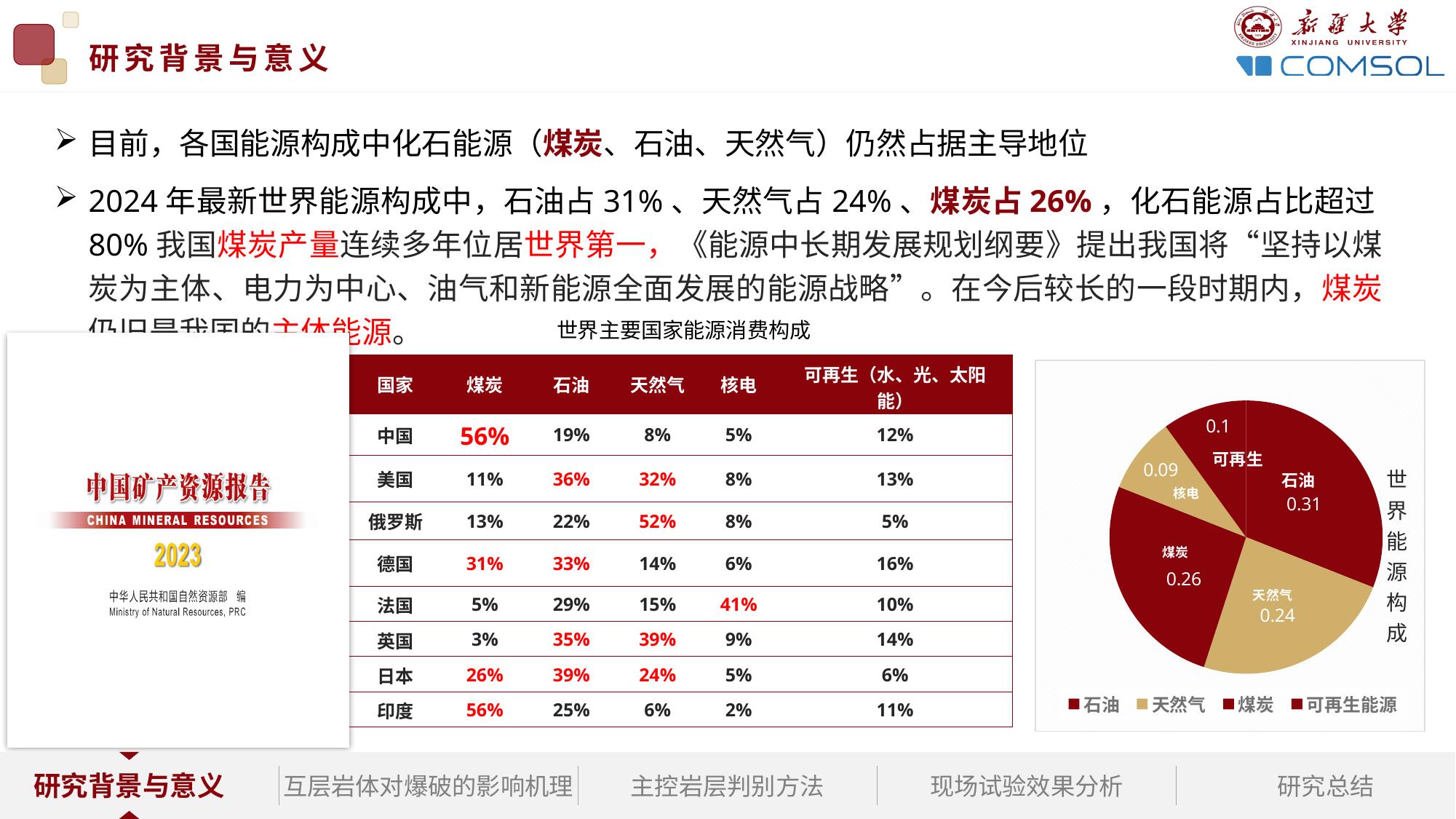
What kind of chart is shown on the right side of the slide? pie chart In the pie chart 世界能源构成, what is the value for 可再生? 0.1 In the pie chart 世界能源构成, what is the value for 核电? 0.09 How many slices does the pie chart 世界能源构成 have? 5 In the pie chart 世界能源构成, which slice has the largest value? 石油 In the pie chart 世界能源构成, which slice has the smallest value? 核电 In the pie chart 世界能源构成, what is the value for 天然气? 0.24 How many entries does the legend of the pie chart 世界能源构成 list? 4 In the pie chart 世界能源构成, what is the value for 石油? 0.31 In the pie chart 世界能源构成, what is the difference between the values for 石油 and 天然气? 0.07 In the pie chart 世界能源构成, which is larger, 煤炭 or 天然气? 煤炭 In the pie chart 世界能源构成, what is the value for 煤炭? 0.26